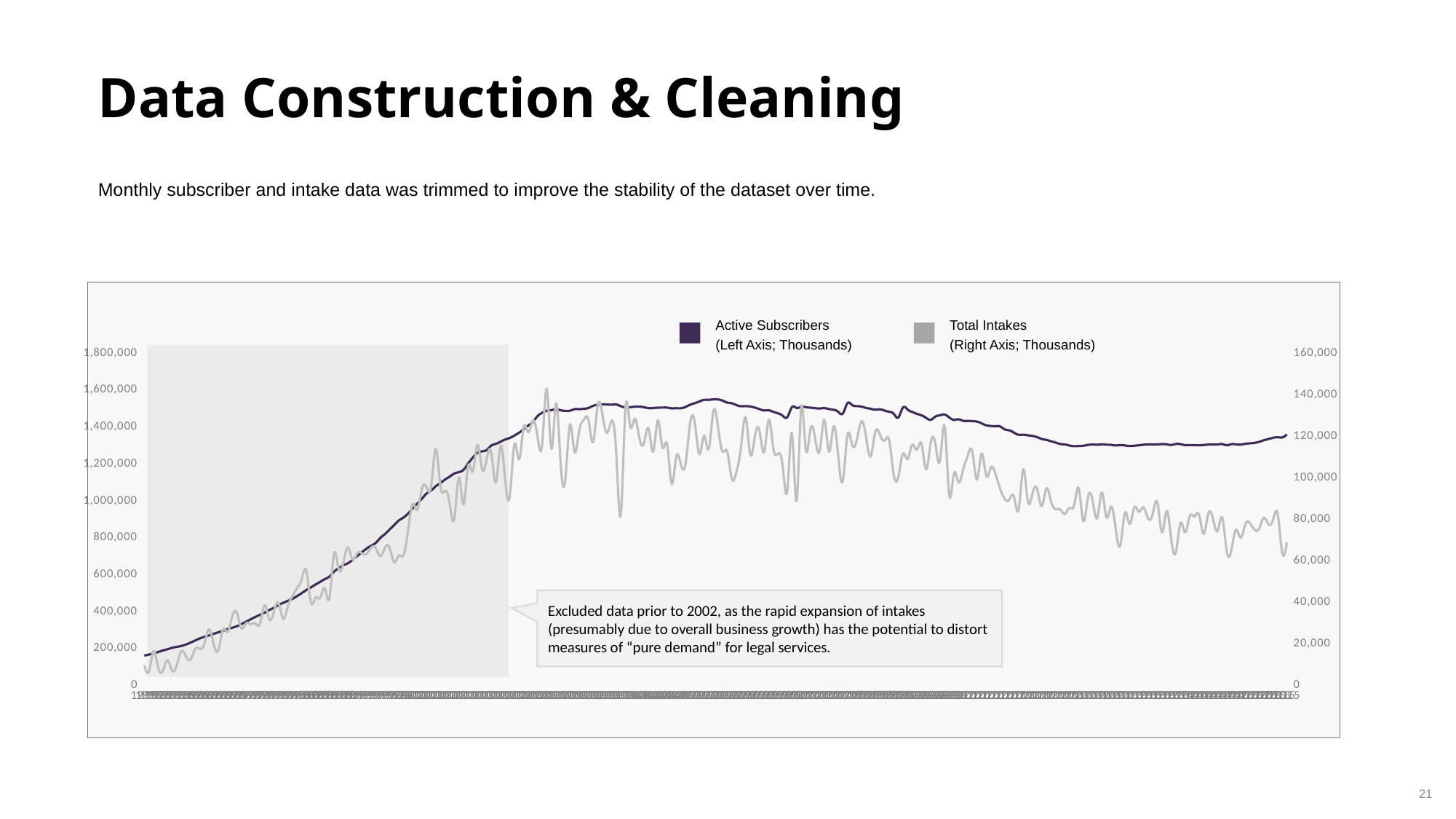
What kind of chart is shown on the slide? line chart Is the final value of the Total Intakes line greater or less than 80,000? less Which axis is the Total Intakes series plotted against? Right axis How many series does the chart's legend list? 2 What are the two series named in the chart's legend? Active Subscribers and Total Intakes Is the starting value of the Active Subscribers line greater or less than 400,000? less Does the Active Subscribers line end higher or lower than it starts? higher Does the Total Intakes line rise or fall over the right-hand half of the chart? fall Does the Active Subscribers line rise or fall across the shaded region at the left of the chart? rise Is the peak of the Active Subscribers line greater or less than 1,400,000? greater